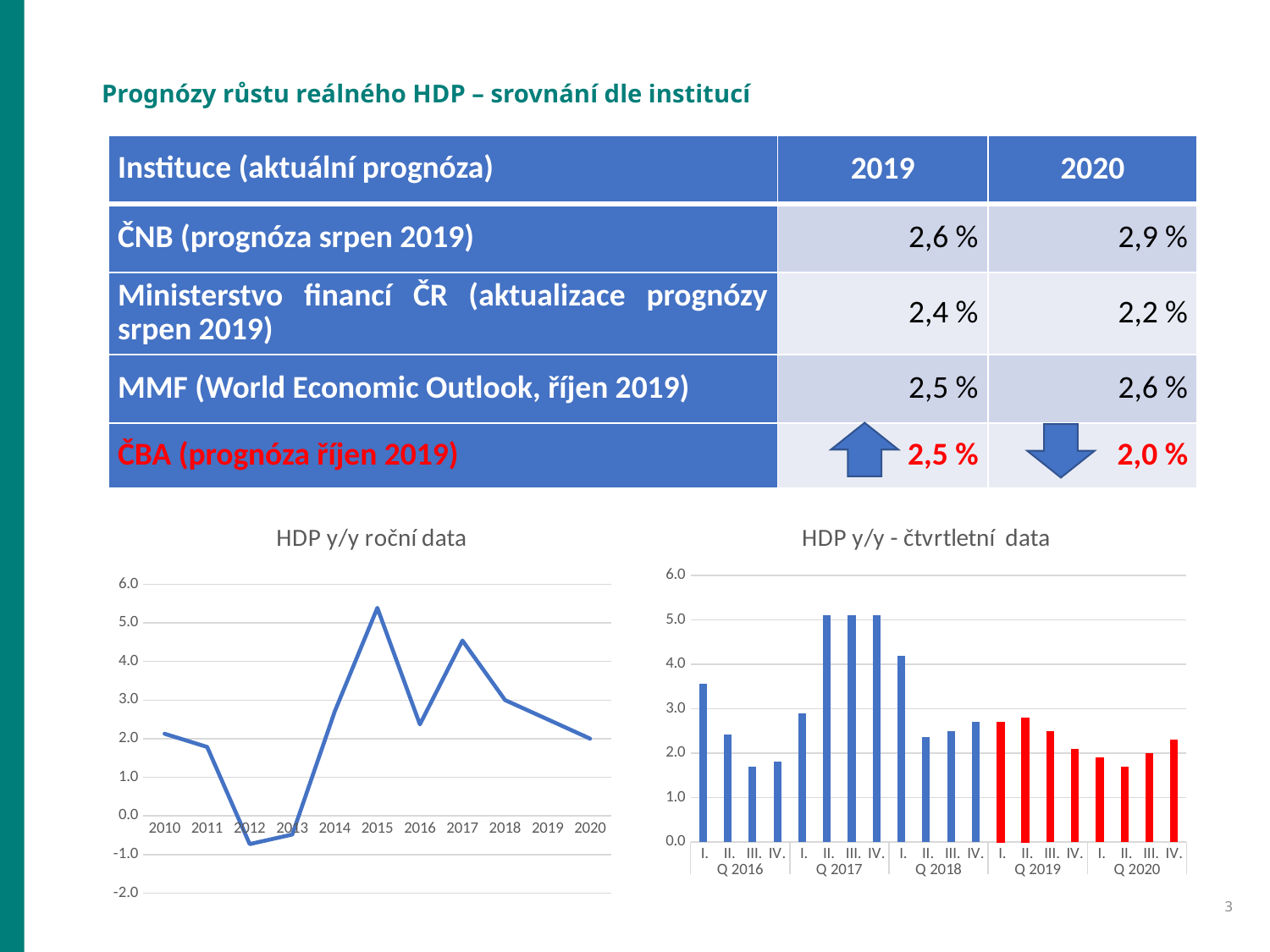
In the 'HDP y/y roční data' chart, does the value rise or fall from 2017 to 2020? fall In the 'HDP y/y - čtvrtletní data' chart, what colour are the bars for Q 2019 and Q 2020? red In the 'HDP y/y roční data' chart, which year has the highest value? 2015 In the 'HDP y/y roční data' chart, is the value for 2015 greater or less than 5.0? greater In the 'HDP y/y - čtvrtletní data' chart, is the value for I. Q 2016 greater or less than 3.0? greater In the 'HDP y/y roční data' chart, is the value for 2012 greater or less than 0.0? less In the 'HDP y/y roční data' chart, which year has the lowest value? 2012 In the 'HDP y/y - čtvrtletní data' chart, how many bars are plotted? 20 What kind of chart is the 'HDP y/y - čtvrtletní data' chart? bar chart In the 'HDP y/y - čtvrtletní data' chart, which is larger, the value for I. Q 2017 or I. Q 2018? I. Q 2018 What kind of chart is the 'HDP y/y roční data' chart? line chart In the 'HDP y/y roční data' chart, how many years are plotted on the x axis? 11